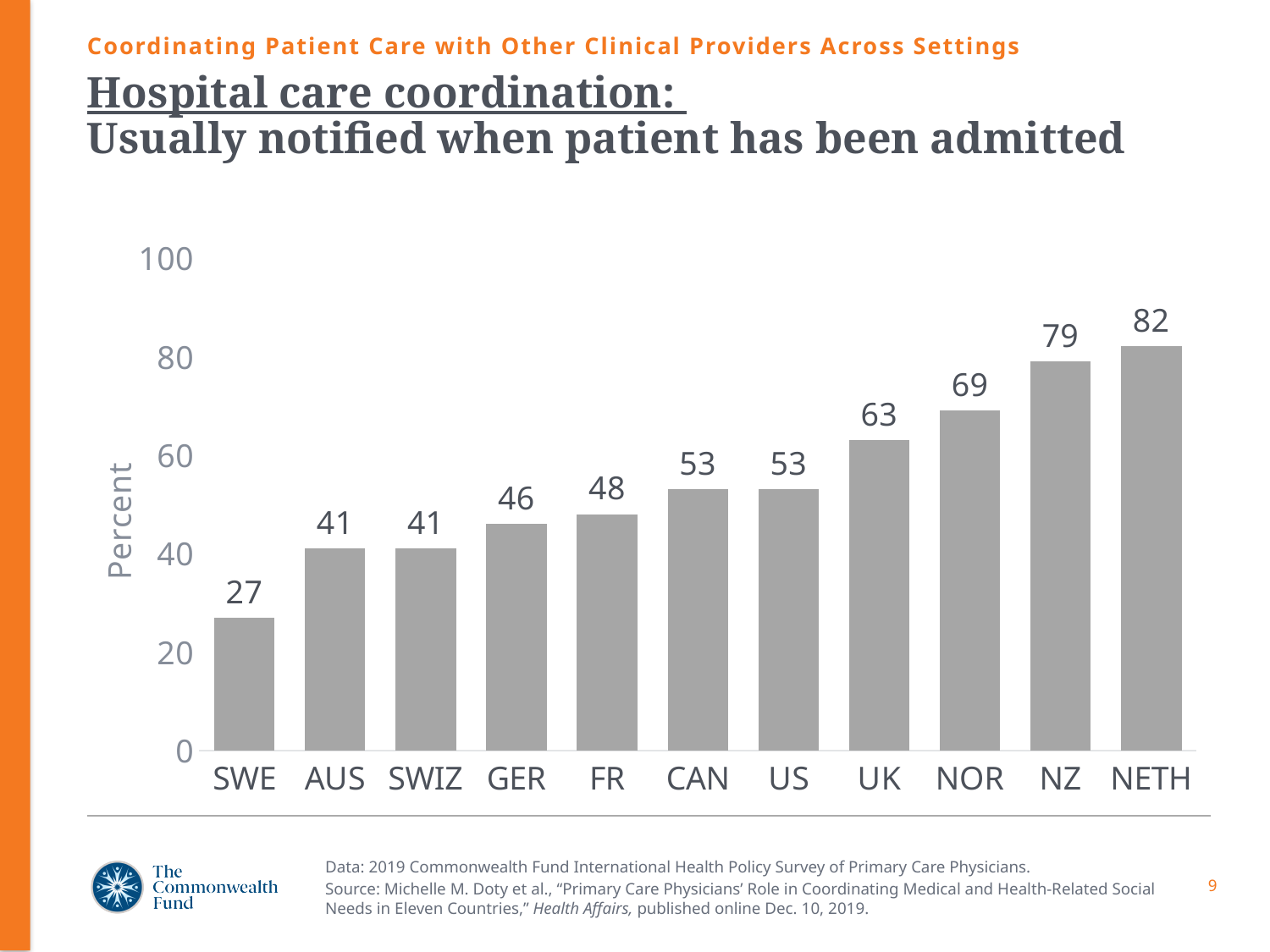
Which country has the highest value? NETH What is the value for NOR? 69 Which country has the lowest value? SWE Which is larger, the value for NZ or the value for UK? NZ How many countries are shown on the x axis? 11 What is the label on the y axis? Percent What is the value for SWE? 27 What is the value for GER? 46 What kind of chart is shown on the slide? bar chart What is the difference between the values for UK and FR? 15 What is the difference between the values for NETH and SWE? 55 Is the value for CAN greater or less than 60? less